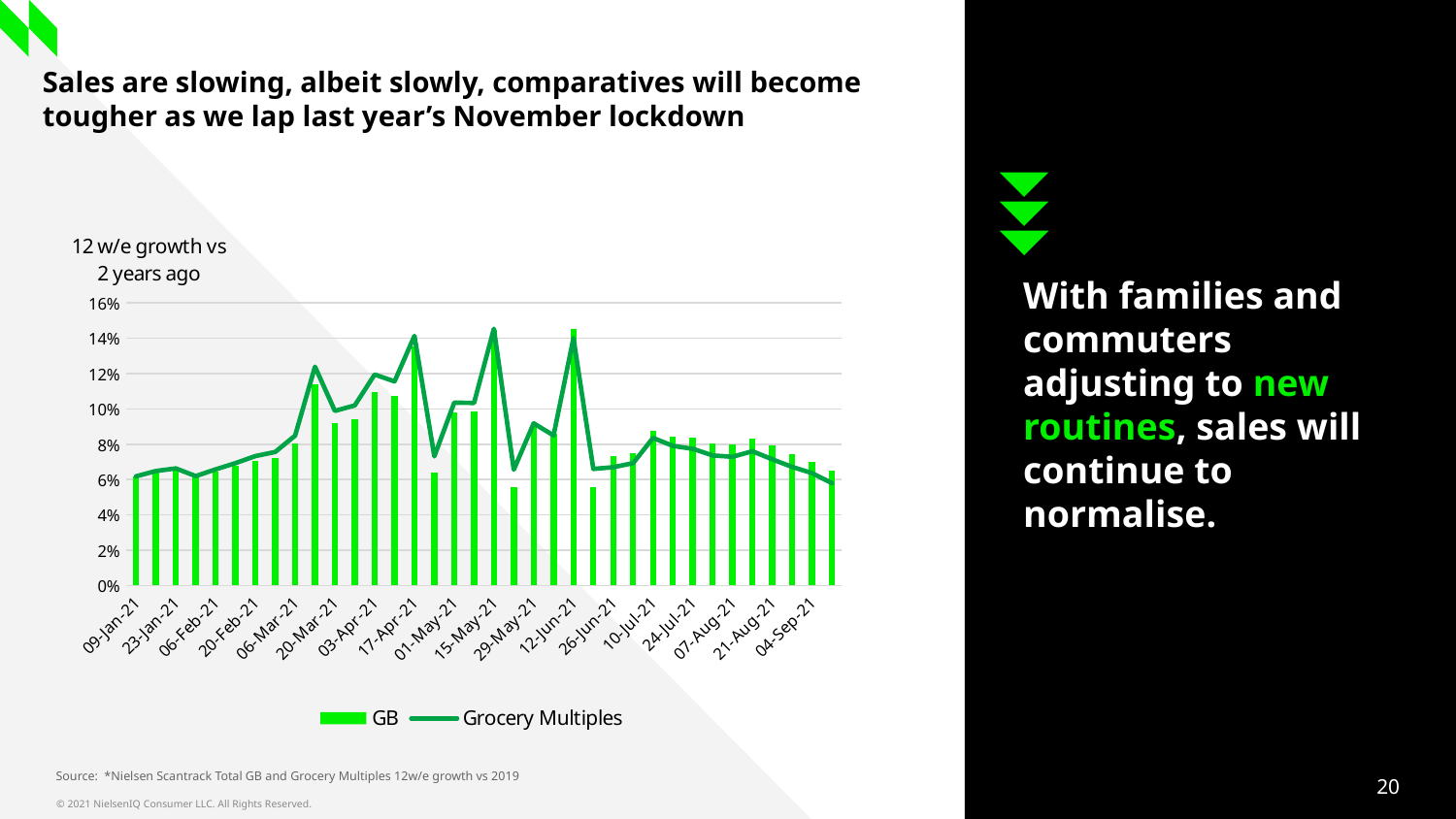
Do the GB values rise or fall from 24-Jul-21 to 04-Sep-21? fall Is the Grocery Multiples value for 17-Apr-21 greater or less than 12%? greater Is the GB value for 20-Mar-21 greater or less than 10%? less Is the GB value for 04-Sep-21 greater or less than 8%? less How many series does the legend list? 2 Which is larger, the GB value for 12-Jun-21 or the GB value for 26-Jun-21? 12-Jun-21 Which series is drawn as bars and which as a line? GB is bars; Grocery Multiples is a line What is the title shown above the vertical axis of the chart? 12 w/e growth vs 2 years ago Which is larger, the Grocery Multiples value for 17-Apr-21 or for 09-Jan-21? 17-Apr-21 What kind of chart is shown on the slide? A combination bar and line chart